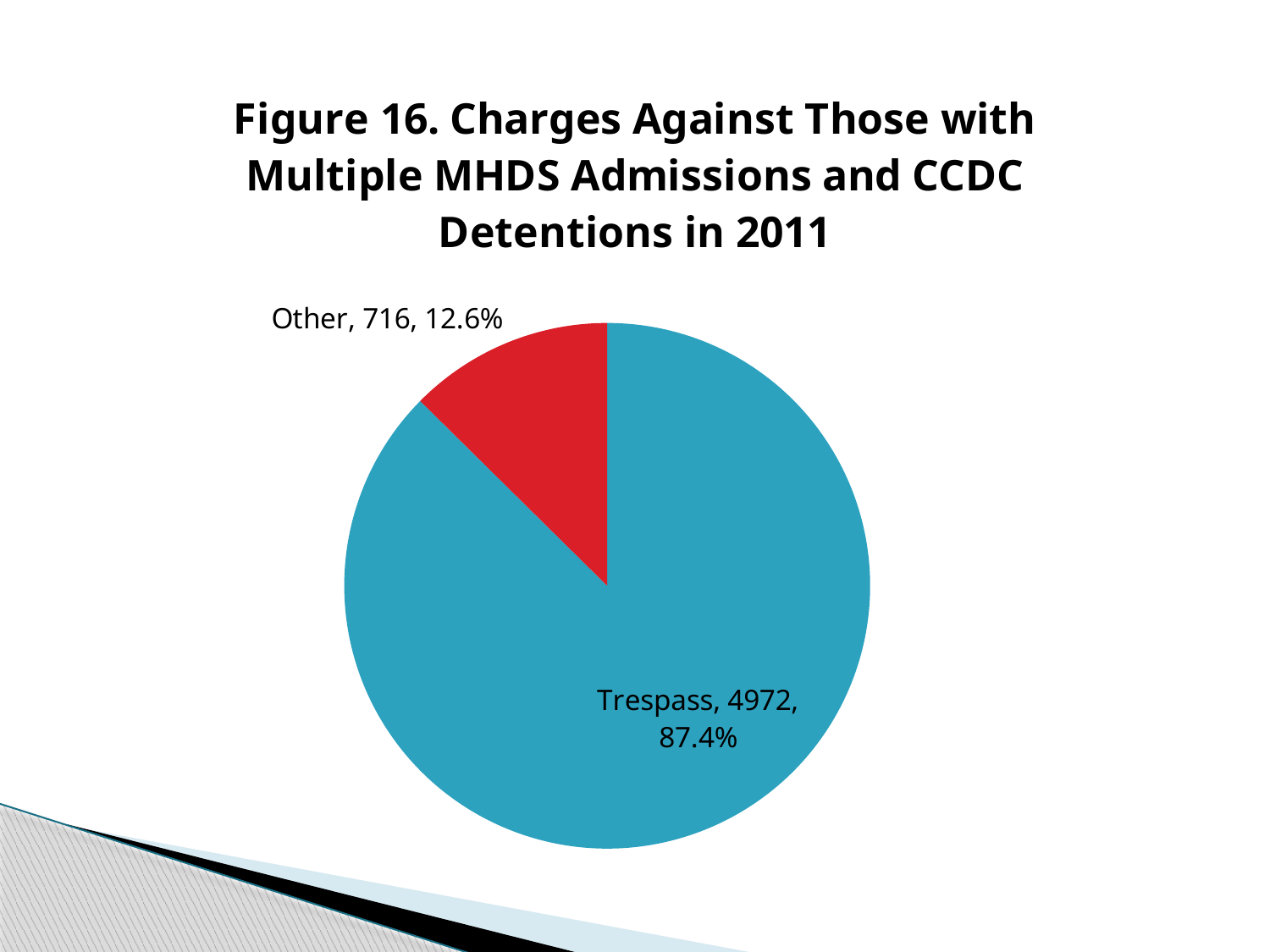
What share of the pie does Other represent? 12.6% What colour is the Other slice? red What is the total of the two slices? 5688 What share of the pie does Trespass represent? 87.4% Which category has the smallest slice? Other What is the value for Trespass? 4972 Which is larger, the value for Trespass or the value for Other? Trespass What is the difference between the Trespass and Other values? 4256 Which category has the largest slice? Trespass How many slices does the pie chart have? 2 What is the value for Other? 716 What kind of chart is shown on the slide? pie chart